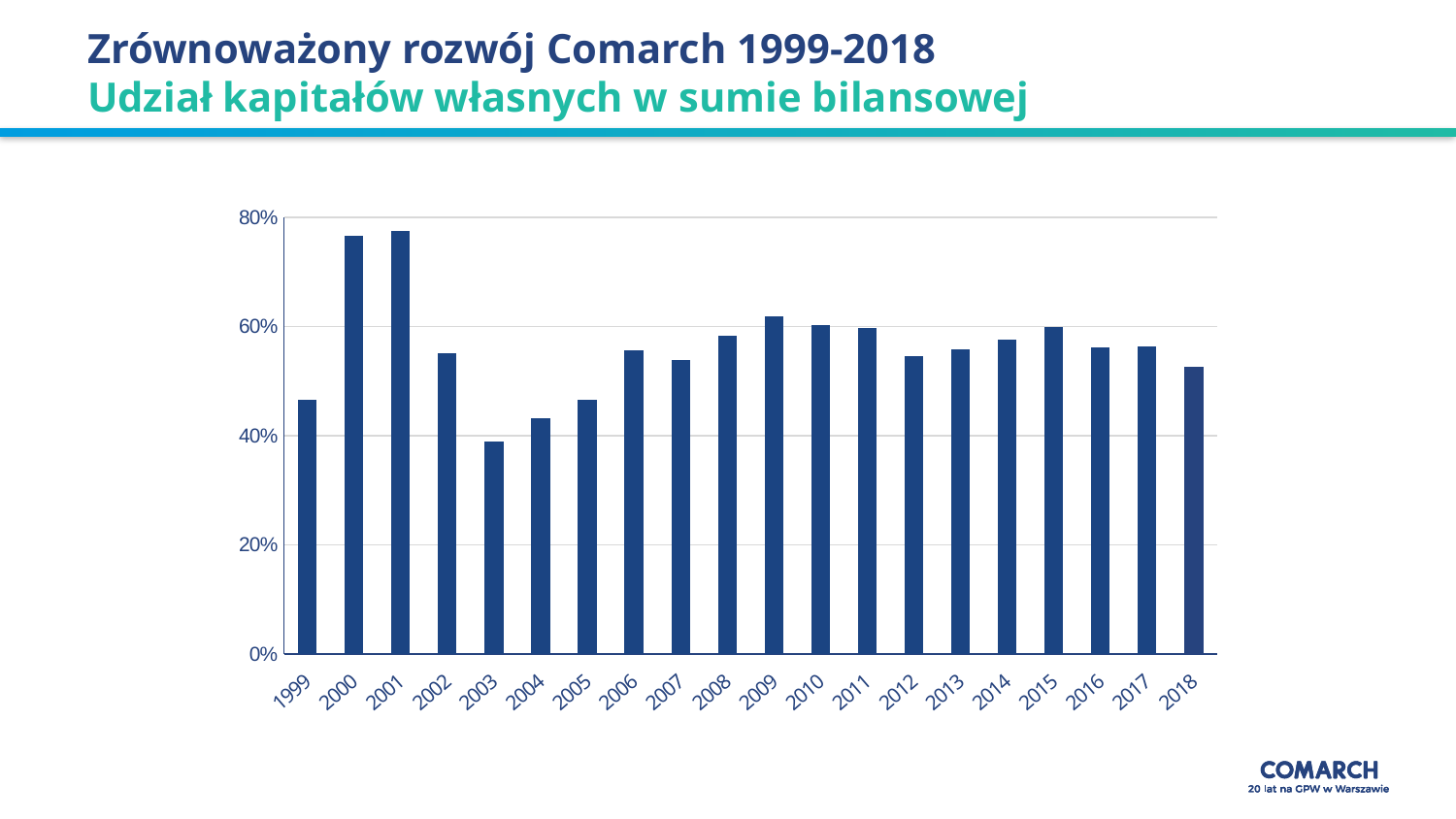
Is the value for 2004 greater or less than 40%? greater Is the value for 2003 greater or less than 40%? less What kind of chart is shown on the slide? bar chart Which year has the lowest value in the chart? 2003 Is the value for 2018 greater or less than 60%? less How many years are shown on the x axis of the chart? 20 Which is larger, the value for 2000 or the value for 2003? 2000 Which is larger, the value for 2009 or the value for 2007? 2009 What is the subtitle of the chart shown in green on the slide? Udział kapitałów własnych w sumie bilansowej Do the values rise or fall from 2001 to 2003? fall